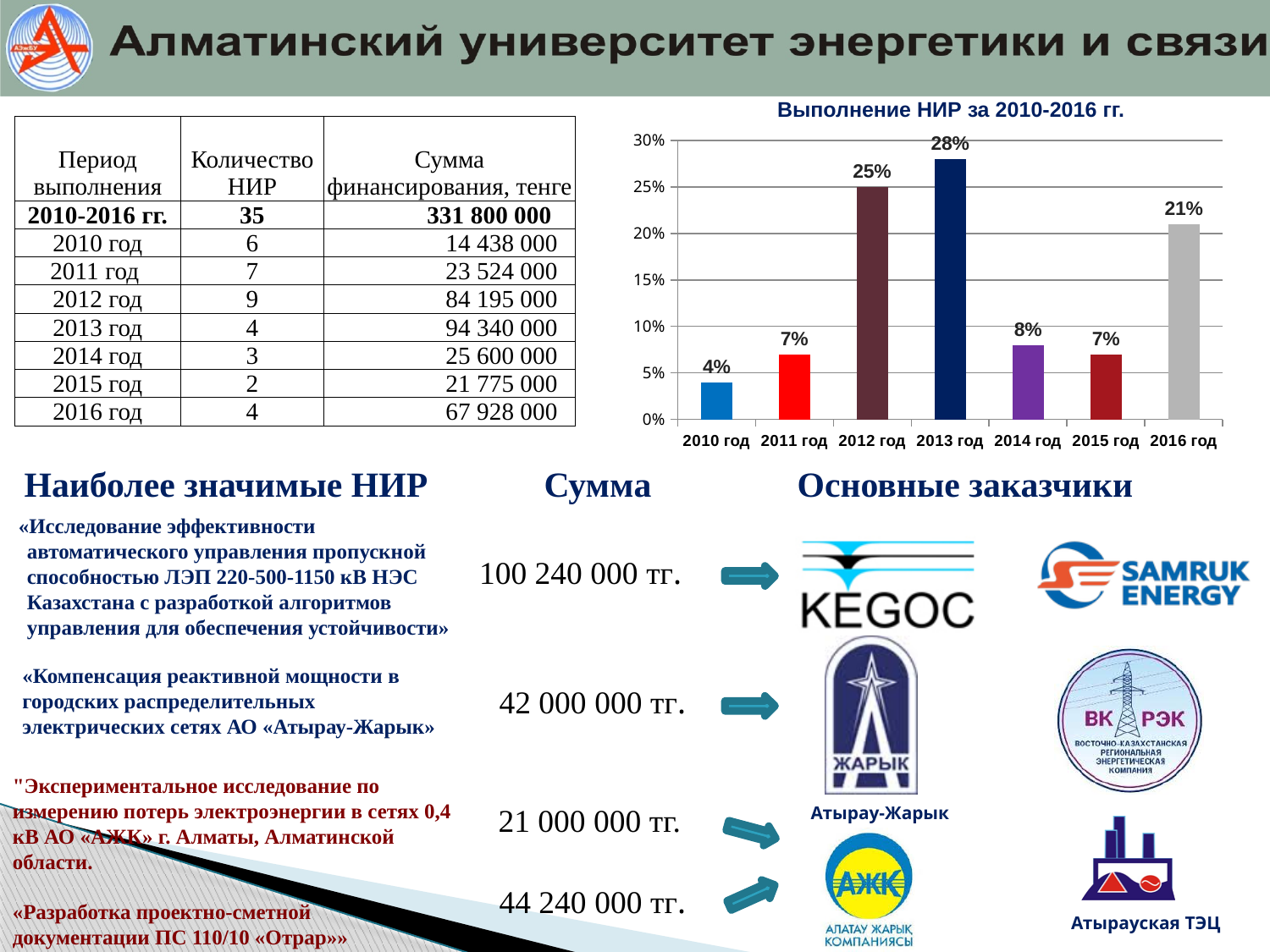
What is the difference between the values for 2013 год and 2012 год? 3% What is the title of the chart? Выполнение НИР за 2010-2016 гг. Which year has the highest value in the chart? 2013 год Which is larger, the value for 2012 год or the value for 2016 год? 2012 год What is the value for 2013 год in the chart? 28% How many years are shown on the x axis of the chart? 7 What is the value for 2010 год in the chart? 4% Which year has the lowest value in the chart? 2010 год Is the value for 2014 год greater or less than 10%? less What is the value for 2016 год in the chart? 21% What kind of chart is shown on the slide? bar chart What is the difference between the values for 2016 год and 2014 год? 13%